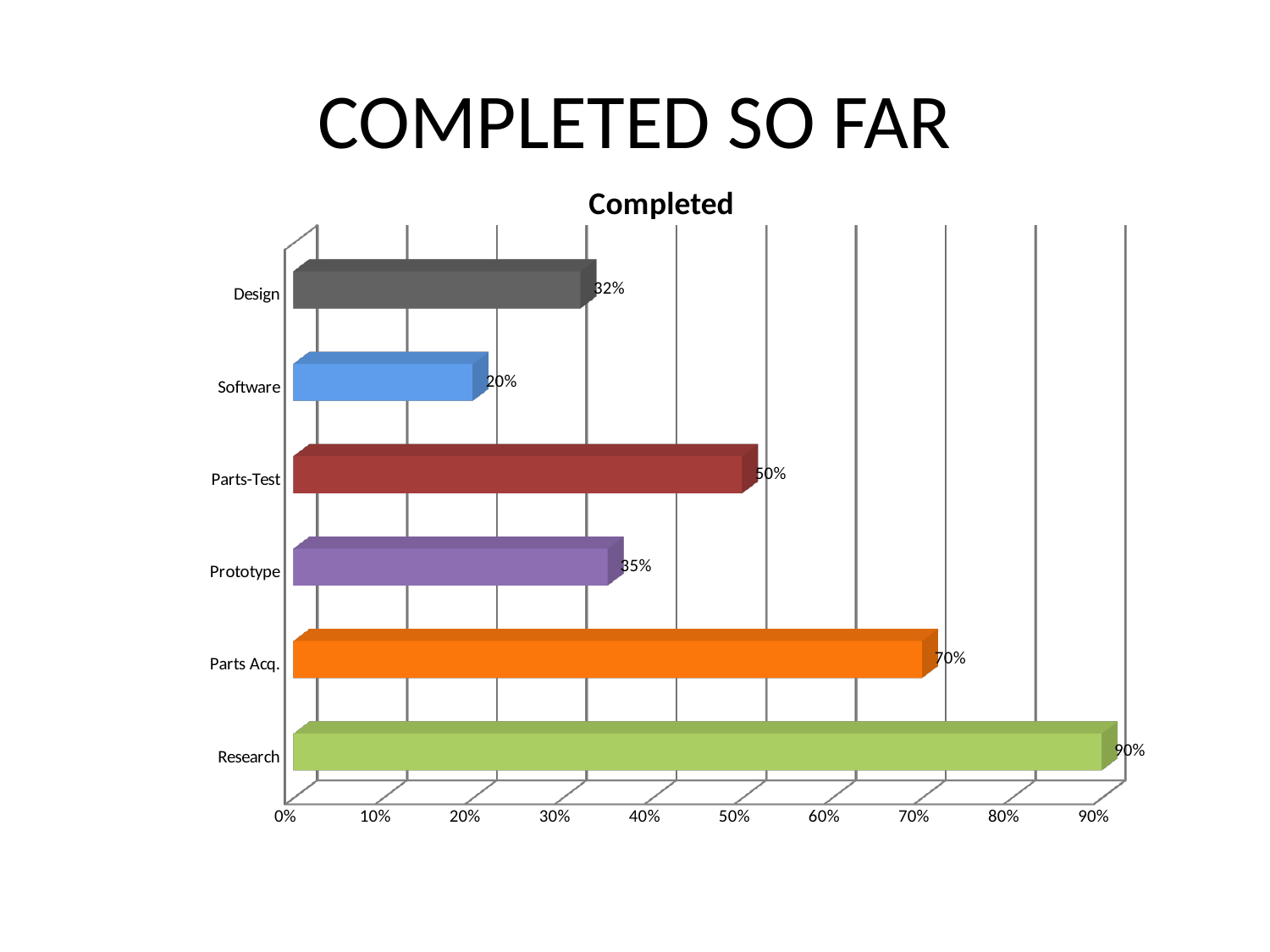
What is the completed percentage for Software? 20% What is the title of the chart? Completed What is the completed percentage for Parts-Test? 50% What is the difference between the completed percentages for Parts Acq. and Prototype? 35% What kind of chart is shown on the slide? Bar chart What is the completed percentage for Research? 90% Which category has the highest completed percentage? Research How many categories are shown in the chart? 6 Which category has the lowest completed percentage? Software Is the value for Parts Acq. greater or less than 60%? greater What is the completed percentage for Design? 32% Which has a higher completed percentage, Prototype or Design? Prototype